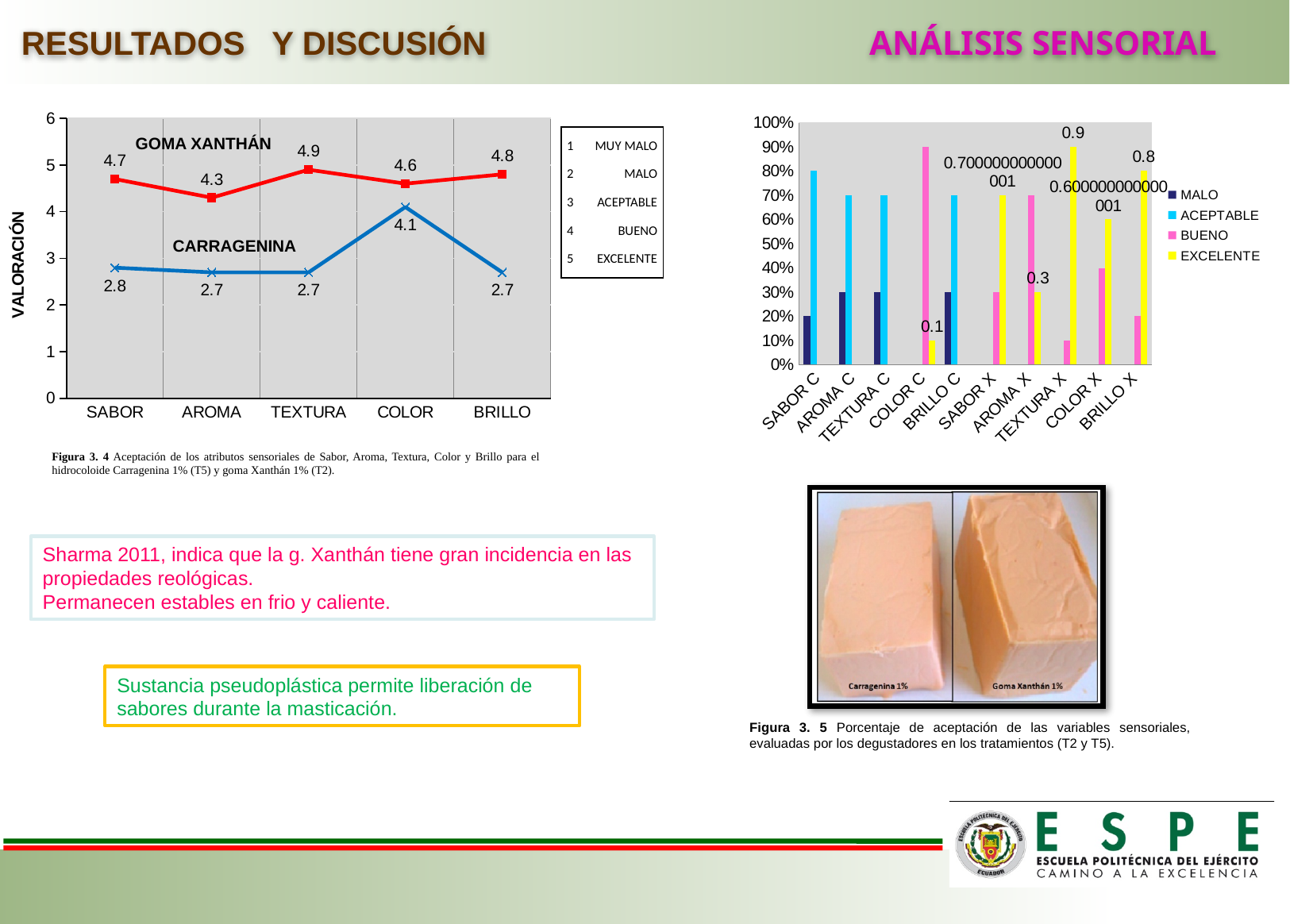
How many series does the legend of the bar chart on the right list? 4 In the line chart on the left, which attribute has the highest value for CARRAGENINA? COLOR In the line chart on the left, what is the value for GOMA XANTHÁN at TEXTURA? 4.9 In the bar chart on the right, which series is shown in yellow? EXCELENTE In the line chart on the left, which series has the larger value at BRILLO, GOMA XANTHÁN or CARRAGENINA? GOMA XANTHÁN How many categories are shown on the x axis of the bar chart on the right? 10 How many attributes are plotted along the x axis of the line chart on the left? 5 In the line chart on the left, what is the difference between GOMA XANTHÁN and CARRAGENINA at SABOR? 1.9 In the line chart on the left, which attribute has the lowest value for GOMA XANTHÁN? AROMA In the bar chart on the right, is the ACEPTABLE value for SABOR C greater or less than 70%? greater In the line chart on the left, what is the value for CARRAGENINA at COLOR? 4.1 What kind of chart is the chart on the left of the slide? Line chart